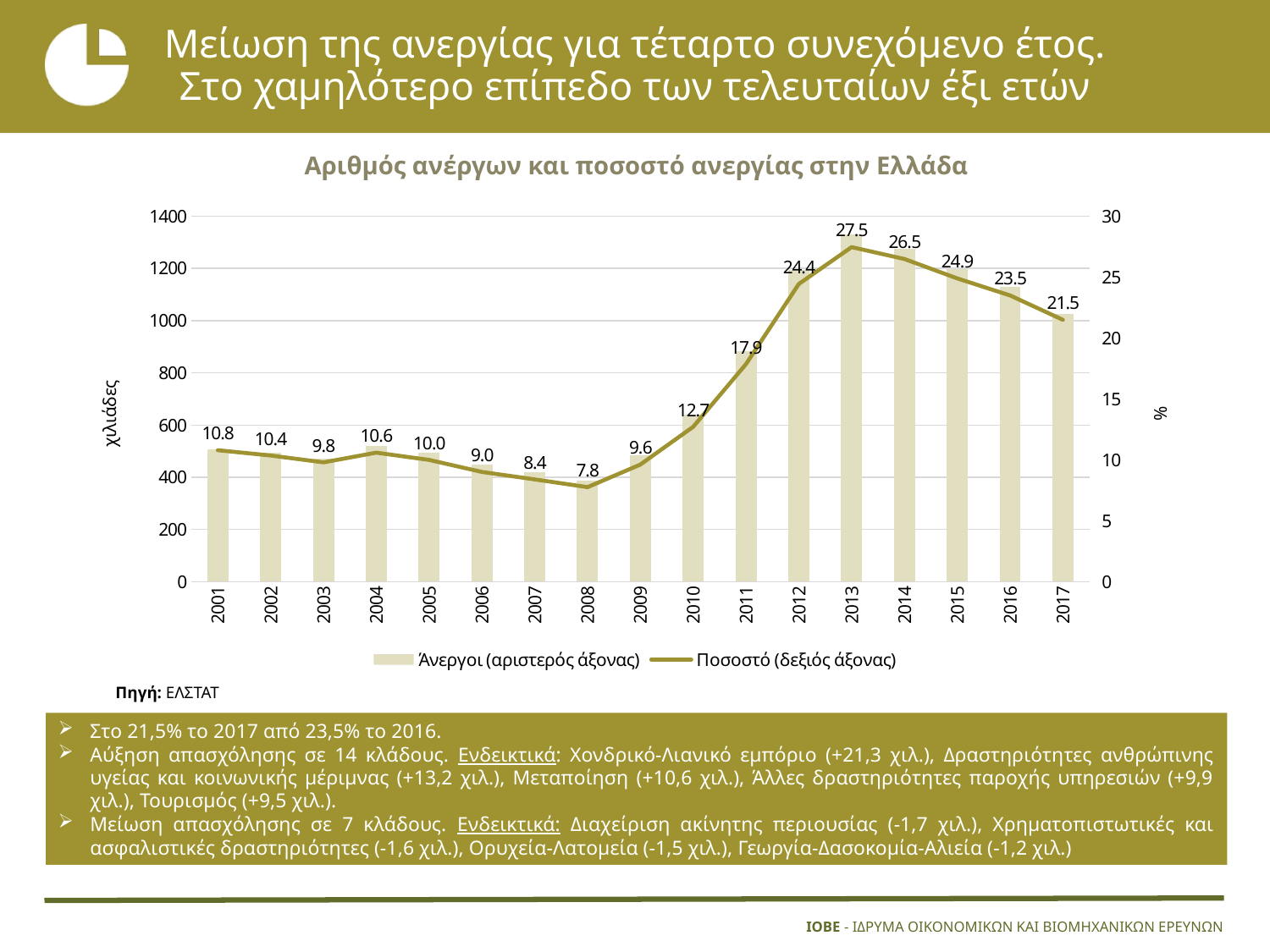
What is the unemployment rate (Ποσοστό) shown for 2013? 27.5 How many years are shown on the x axis of the chart? 17 Which year has a higher unemployment rate (Ποσοστό), 2011 or 2015? 2015 Is the number of unemployed (Άνεργοι, left axis) for 2013 greater or less than 1200? greater What is the unemployment rate (Ποσοστό) shown for 2008? 7.8 What is the unemployment rate (Ποσοστό) shown for 2017? 21.5 By how many percentage points did the unemployment rate (Ποσοστό) fall from 2016 to 2017? 2.0 What is the title of the chart? Αριθμός ανέργων και ποσοστό ανεργίας στην Ελλάδα How many series does the chart legend list? 2 In which year is the unemployment rate (Ποσοστό) highest? 2013 In which year is the unemployment rate (Ποσοστό) lowest? 2008